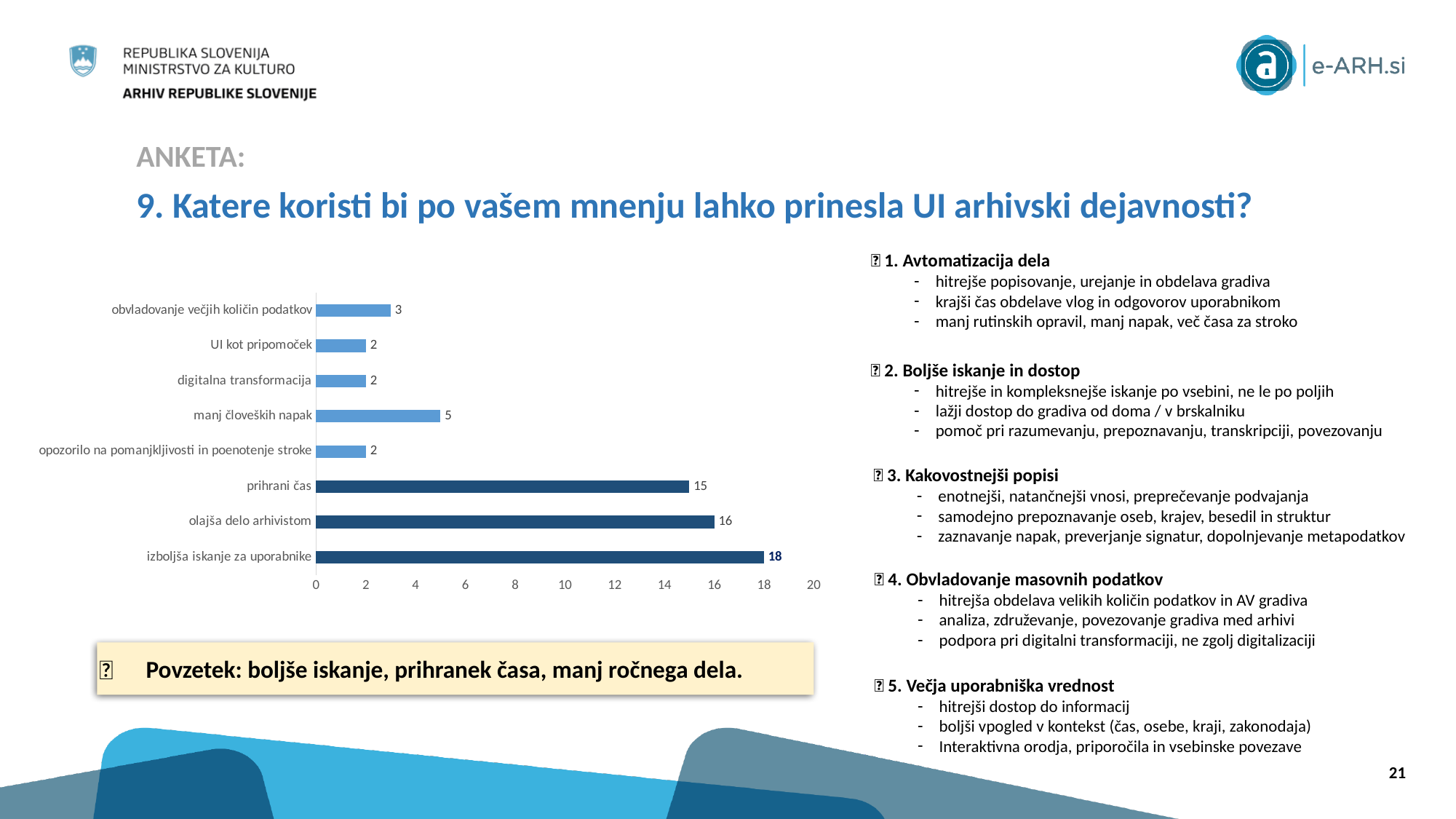
How many categories are shown in the chart? 8 What is the value for "manj človeških napak"? 5 Which category has the highest value? izboljša iskanje za uporabnike What is the value for "izboljša iskanje za uporabnike"? 18 Is the value for "olajša delo arhivistom" greater or less than 10? greater Which is larger, the value for "manj človeških napak" or the value for "UI kot pripomoček"? manj človeških napak How many categories have a value of 2? 3 What is the value for "obvladovanje večjih količin podatkov"? 3 What is the value for "prihrani čas"? 15 What is the difference between the values for "izboljša iskanje za uporabnike" and "manj človeških napak"? 13 What kind of chart is shown on the slide? bar chart What is the difference between the values for "olajša delo arhivistom" and "prihrani čas"? 1